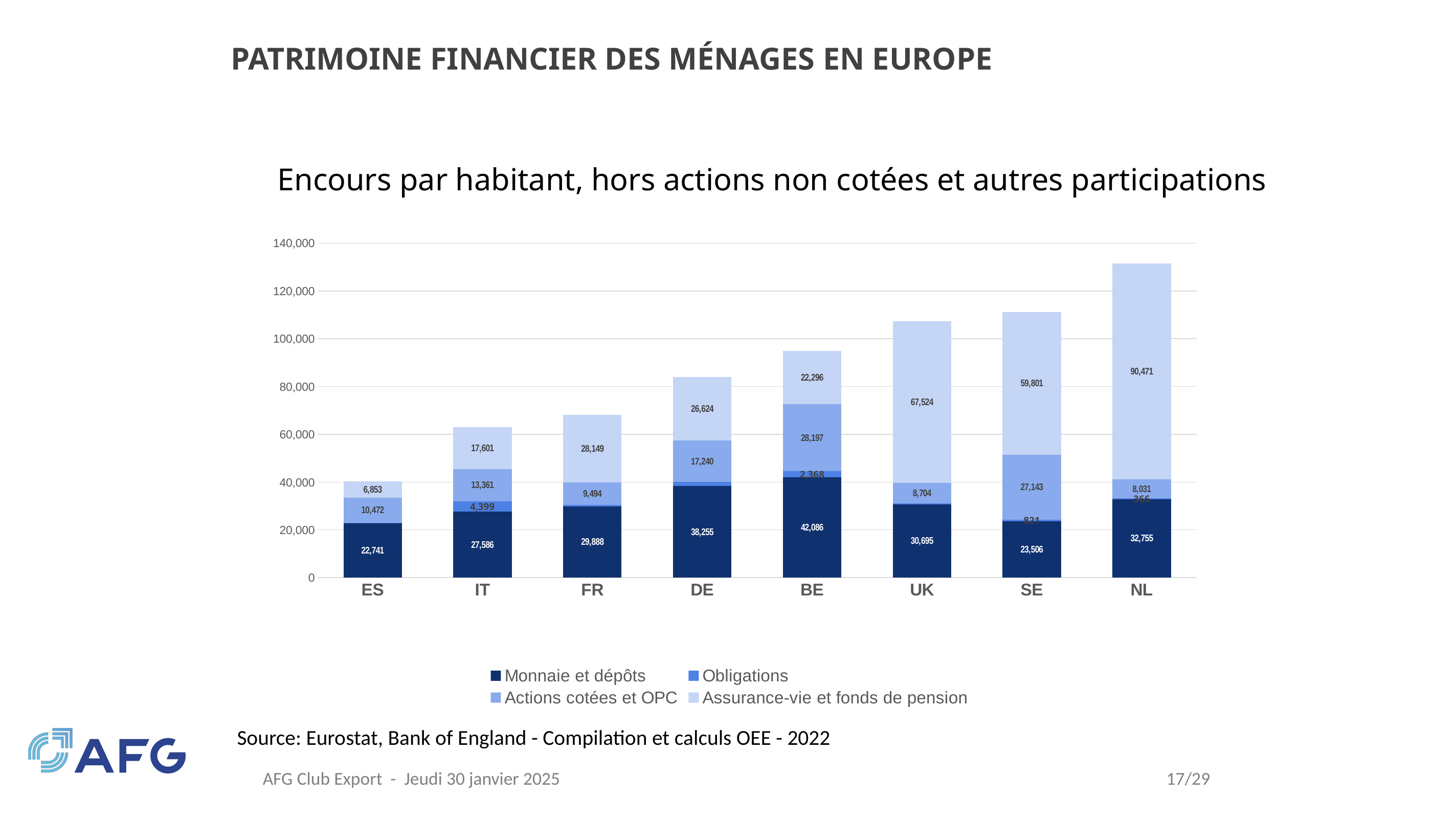
What is the value of Assurance-vie et fonds de pension for UK? 67,524 Which is larger, the Monnaie et dépôts value for IT or for FR? FR What is the value of Actions cotées et OPC for SE? 27,143 Do the total bar heights generally rise or fall from ES to NL along the x axis? Rise What is the difference between the Monnaie et dépôts values for BE and DE? 3,831 Is the total stacked value for NL greater or less than 120,000? greater Which country has the lowest value for Assurance-vie et fonds de pension? ES How many countries are shown on the x axis of the chart? 8 Which country has the highest value for Monnaie et dépôts? BE What is the value of Monnaie et dépôts for BE? 42,086 How many series does the chart legend list? 4 What type of chart is shown on the slide? Stacked bar chart